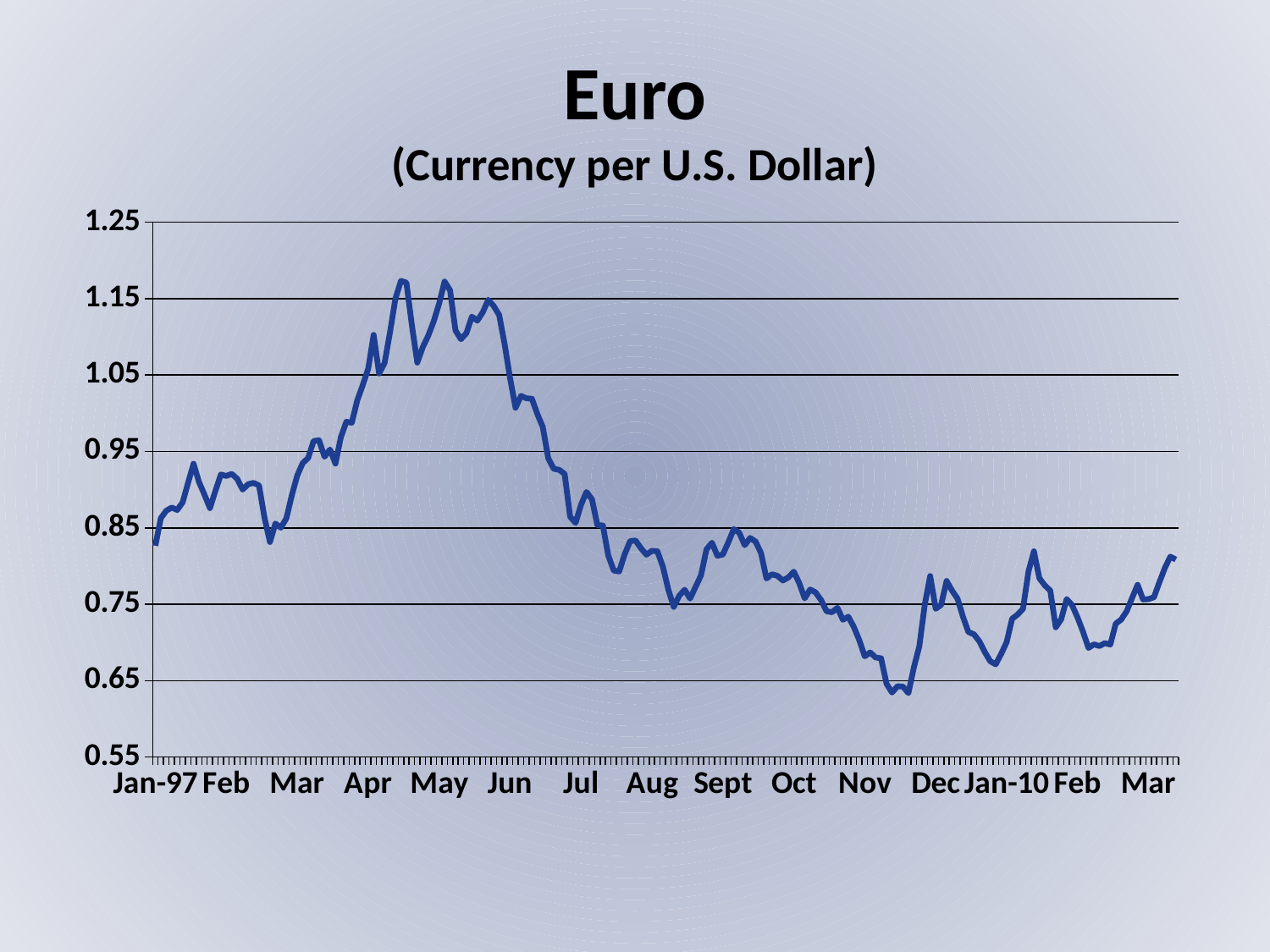
What is the title of the chart? Euro (Currency per U.S. Dollar) Is the value at the final point (Mar) greater or less than 0.75? greater Does the line rise or fall between Feb and Apr? rise Is the highest value reached by the line greater or less than 1.05? greater Is the lowest value reached by the line greater or less than 0.65? less What kind of chart is shown on the slide? line chart Which is larger, the value at May or the value at Nov? May How many lines are plotted on the chart? 1 How many month labels are shown along the x axis? 15 Does the line rise or fall between Jun and Nov? fall